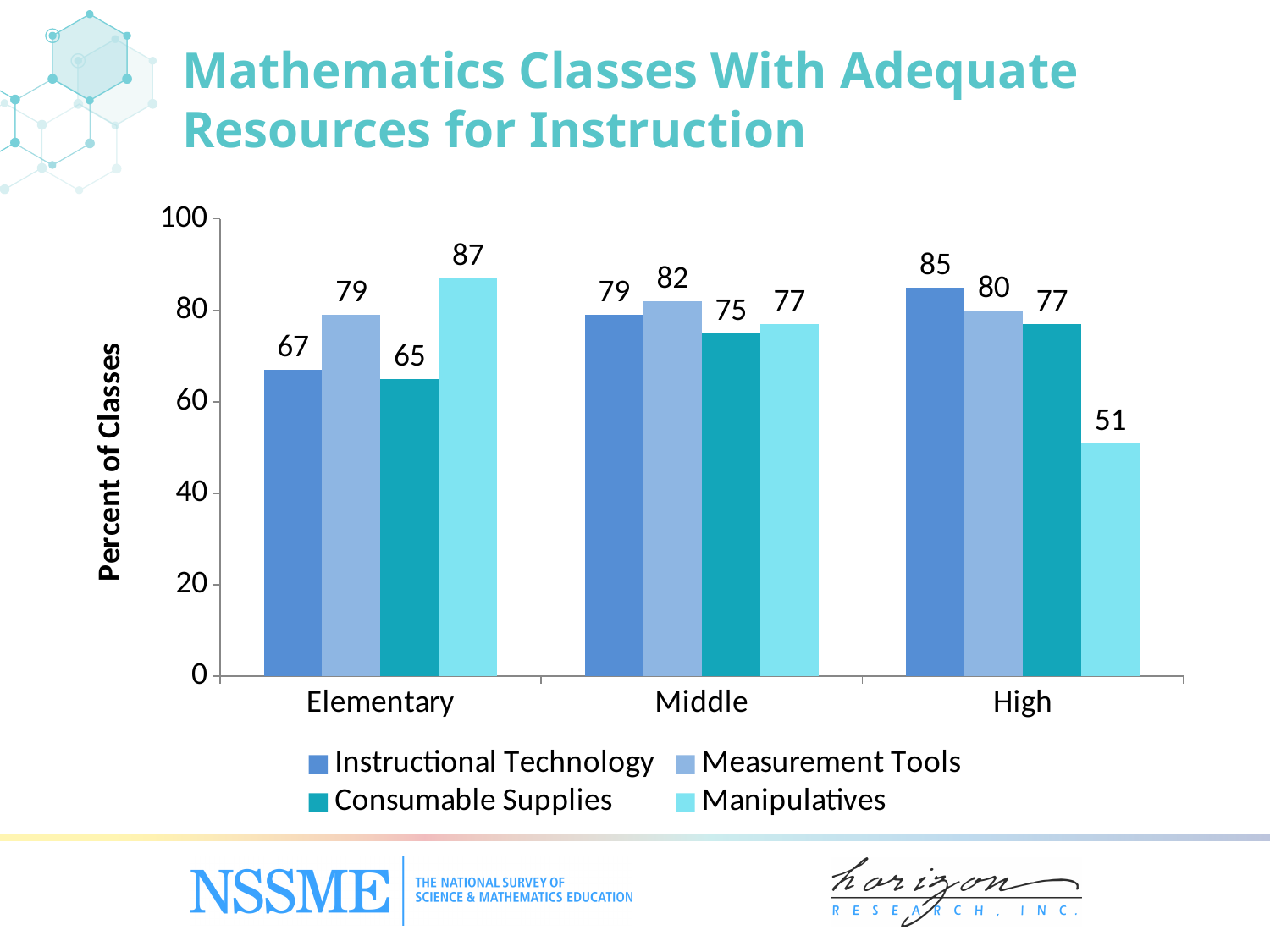
How many grade-level categories are shown on the x axis? 3 Which grade level has the lowest value for Manipulatives? High What is the value for Instructional Technology in High classes? 85 Which is larger in Elementary classes: Instructional Technology or Measurement Tools? Measurement Tools What is the difference between the Manipulatives values for Elementary and High classes? 36 What is the label of the y axis? Percent of Classes What is the value for Consumable Supplies in Middle classes? 75 What kind of chart is shown on the slide? Bar chart What is the value for Manipulatives in Elementary classes? 87 Is the value for Manipulatives in High classes greater or less than 60? less How many series does the legend list? 4 Which grade level has the highest value for Instructional Technology? High